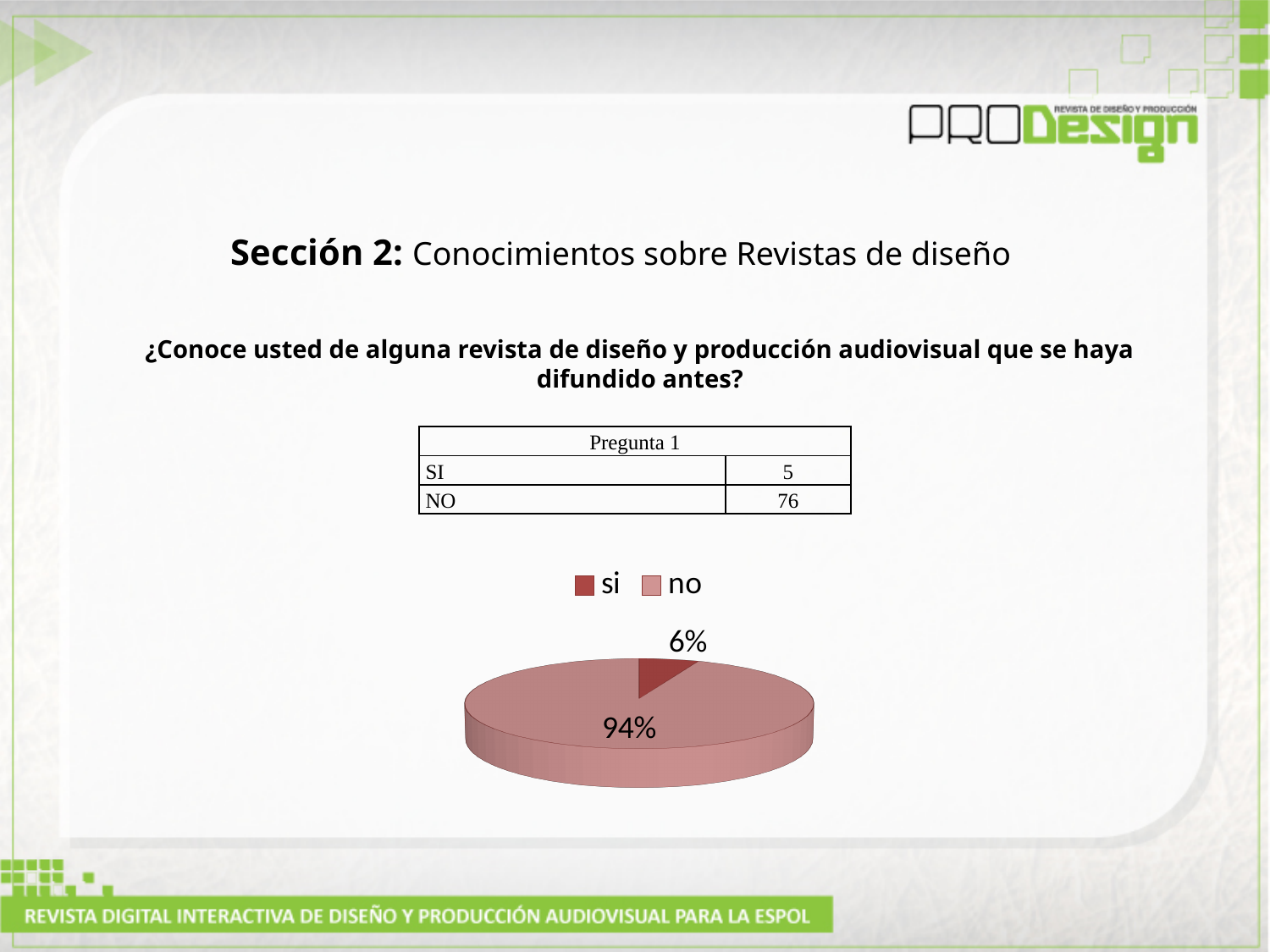
What share of the pie does the "si" slice represent? 6% How many slices does the pie chart have? 2 Which slice of the pie is the smallest? si What share of the pie does the "no" slice represent? 94% Which slice of the pie is the largest? no What are the two entries listed in the legend? si, no Is the share for "no" greater or less than 50%? greater What is the difference in percentage points between the "no" slice and the "si" slice? 88 Which is larger, the "si" slice or the "no" slice? no Is the share for "si" greater or less than 10%? less How many entries does the legend list? 2 What kind of chart is shown on the slide? pie chart